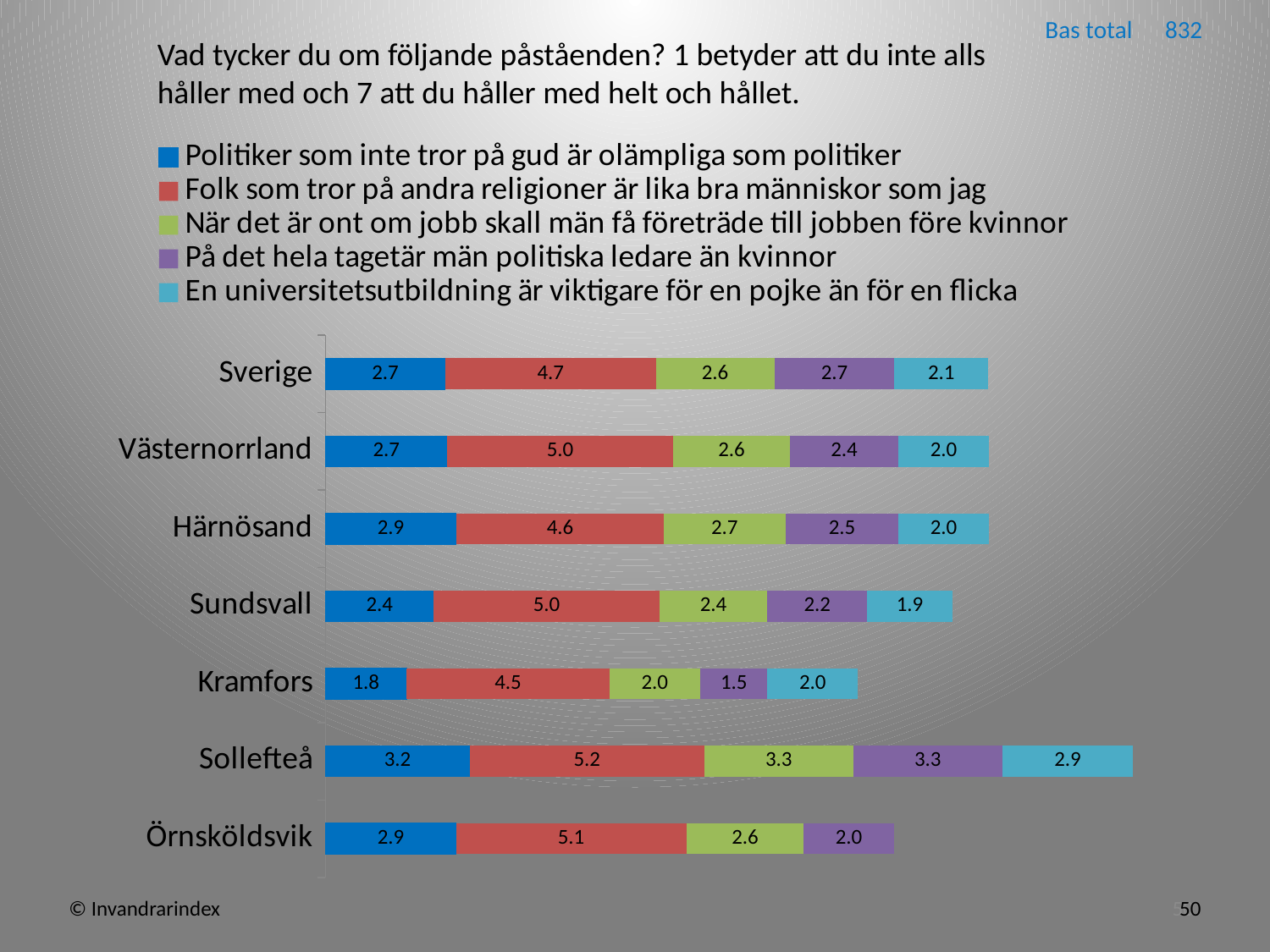
Which region has the lowest value for the series 'Politiker som inte tror på gud är olämpliga som politiker'? Kramfors Which colour represents the series 'När det är ont om jobb skall män få företräde till jobben före kvinnor'? green What is the value for Sverige for the series 'Folk som tror på andra religioner är lika bra människor som jag'? 4.7 What kind of chart is shown on the slide? stacked bar chart What is the total of the stacked bar for Sverige? 14.8 What is the value for Sollefteå for the series 'En universitetsutbildning är viktigare för en pojke än för en flicka'? 2.9 What is the value for Kramfors for the series 'På det hela tagetär män politiska ledare än kvinnor'? 1.5 How many series does the legend list? 5 How many categories (regions) are shown on the chart? 7 What is the difference between Sollefteå and Kramfors for the series 'Politiker som inte tror på gud är olämpliga som politiker'? 1.4 Which region has the highest value for the series 'Folk som tror på andra religioner är lika bra människor som jag'? Sollefteå Which is larger: the value for Härnösand or for Sundsvall for the series 'När det är ont om jobb skall män få företräde till jobben före kvinnor'? Härnösand